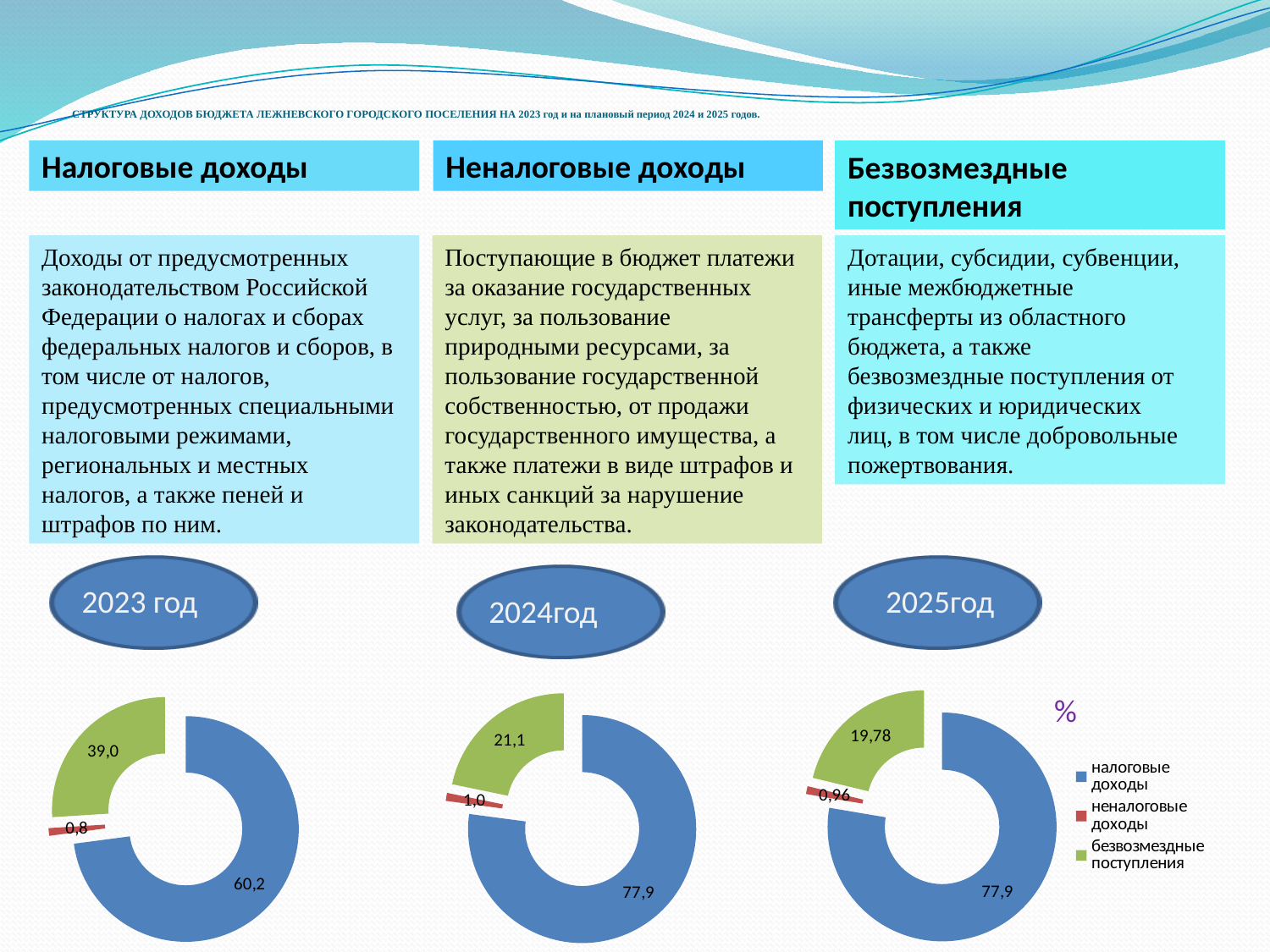
In the 2023 год chart, what is the value for налоговые доходы? 60,2 In the 2025год chart, what is the value for безвозмездные поступления? 19,78 Which is larger in the 2025год chart: налоговые доходы or безвозмездные поступления? налоговые доходы How many categories does each of the three charts show? 3 In the 2023 год chart, what is the value for безвозмездные поступления? 39,0 In the 2023 год chart, what is the difference between the values for налоговые доходы and безвозмездные поступления? 21,2 In the 2023 год chart, which category has the smallest share? неналоговые доходы Which colour represents безвозмездные поступления in the legend? green In the 2024год chart, which category has the largest share? налоговые доходы In the 2024год chart, what is the value for неналоговые доходы? 1,0 What kind of chart is used for the 2024год data? doughnut (pie) chart In the 2025год chart, what is the value for неналоговые доходы? 0,96